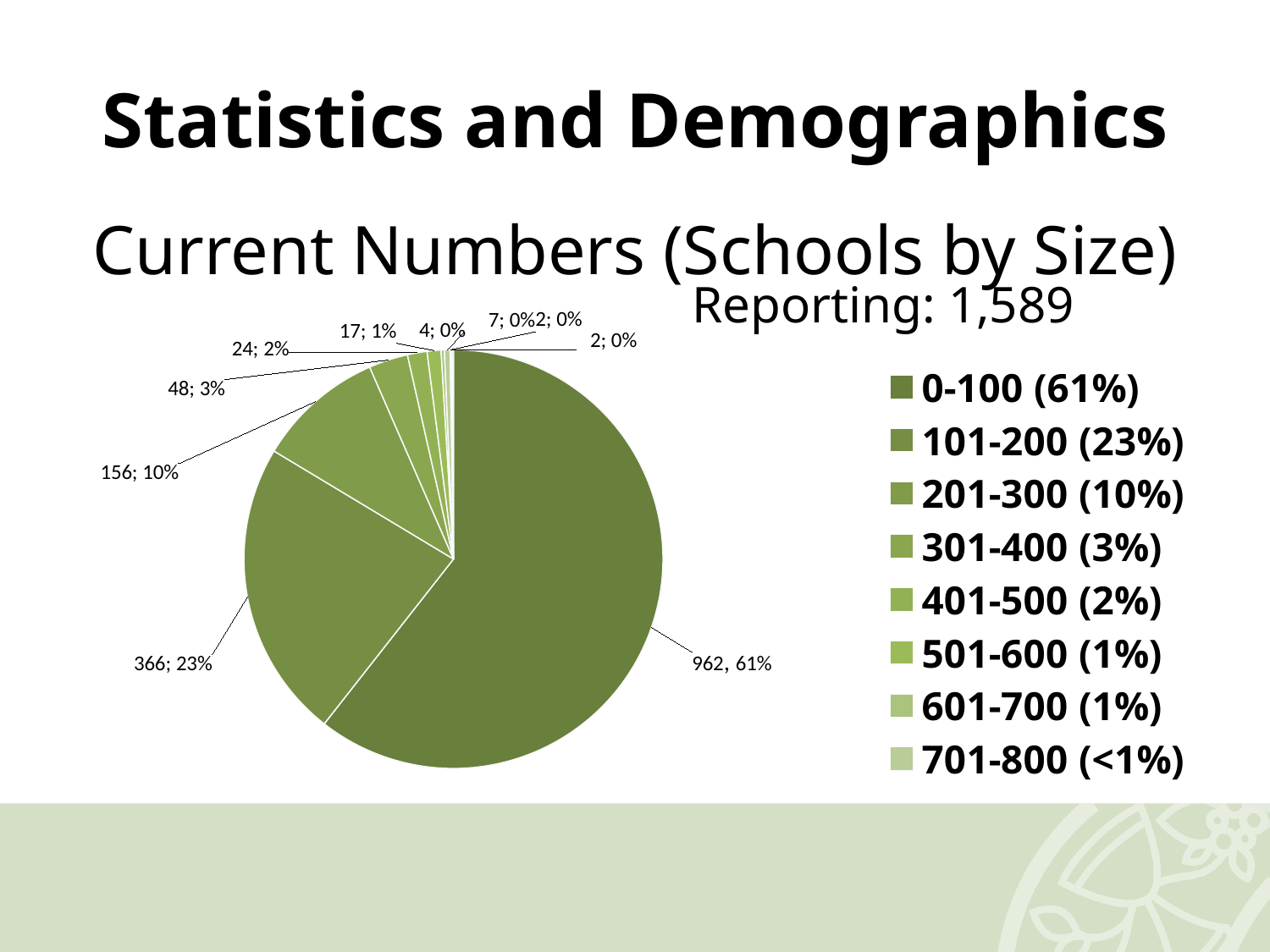
What share of the pie does the 0-100 category take? 61% How many categories does the legend list? 8 Which is larger, the value for 101-200 or the value for 201-300? 101-200 Which category has the largest slice? 0-100 What is the title of the chart? Current Numbers (Schools by Size) What kind of chart is shown on the slide? pie chart What is the value for the 0-100 category? 962 What is the difference between the values for 0-100 and 101-200? 596 What is the value for the 101-200 category? 366 What share of the pie does the 101-200 category take? 23% What is the value for the 201-300 category? 156 What is the value for the 301-400 category? 48